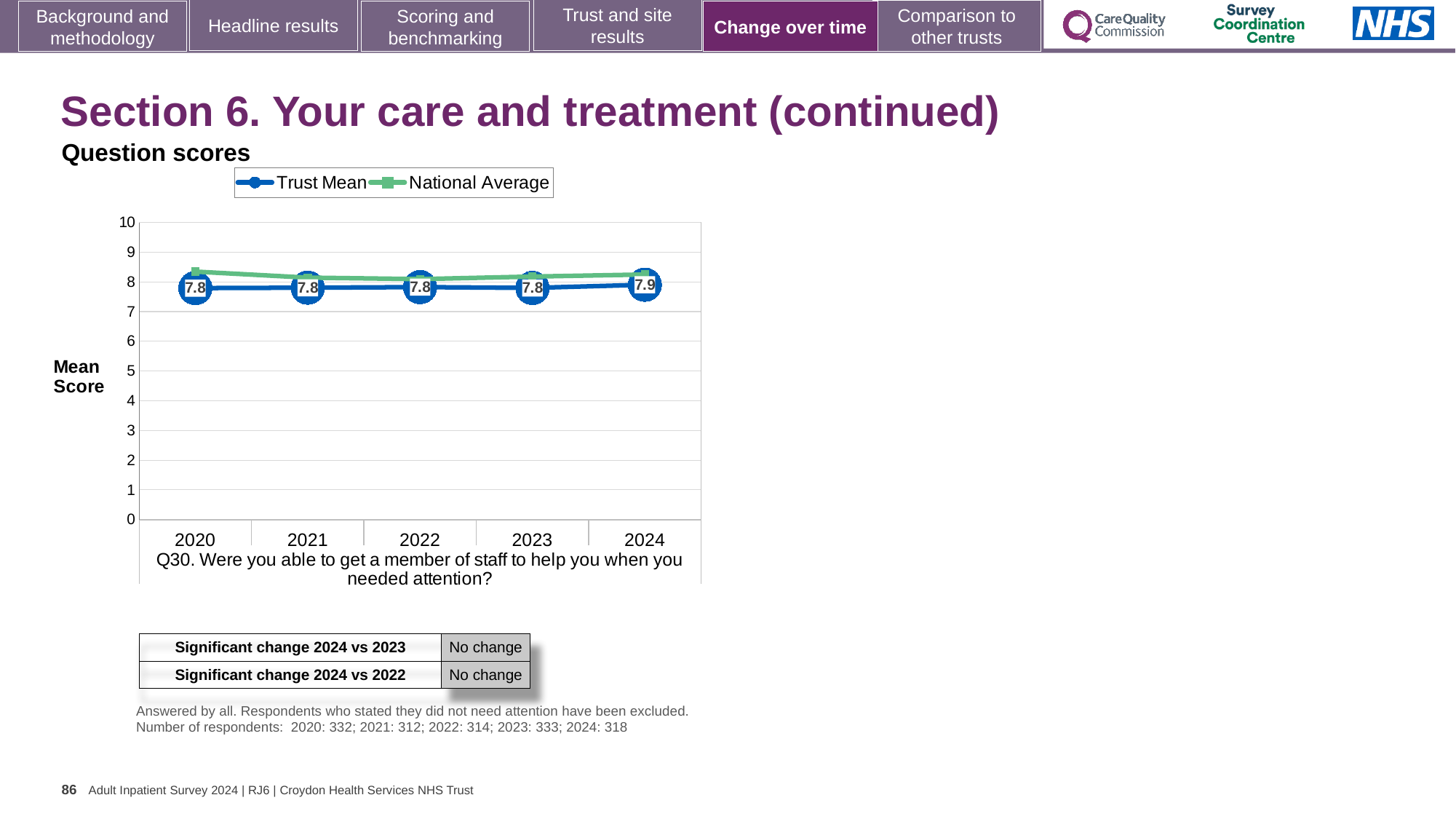
Is the National Average for 2020 greater or less than 8? greater What is the Trust Mean score for 2024? 7.9 What kind of chart is shown on the slide? line chart What is the difference between the Trust Mean score in 2024 and in 2023? 0.1 What is the Trust Mean score for 2022? 7.8 How many years are plotted on the x axis? 5 What is the Trust Mean score for 2020? 7.8 How many series does the legend list? 2 Is the Trust Mean score for 2024 greater or less than 8? less Which year has the highest Trust Mean score? 2024 In 2020, which is larger, the Trust Mean or the National Average? National Average Which question does the chart show scores for? Q30. Were you able to get a member of staff to help you when you needed attention?